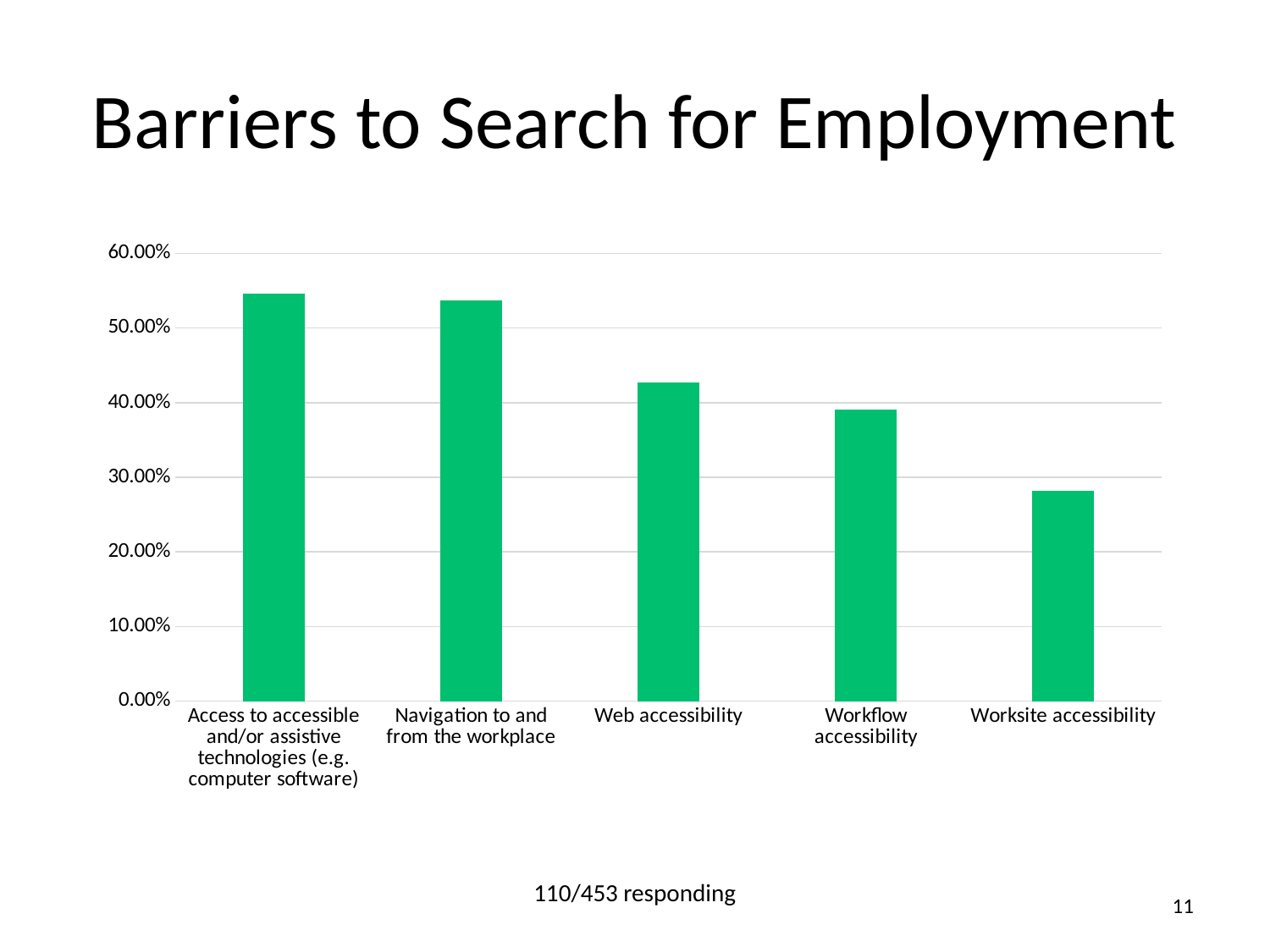
Is the value for Worksite accessibility greater or less than 30.00%? less Which is larger, the value for Navigation to and from the workplace or the value for Workflow accessibility? Navigation to and from the workplace Which is larger, the value for Web accessibility or the value for Worksite accessibility? Web accessibility What is the title of the chart on the slide? Barriers to Search for Employment Is the value for Access to accessible and/or assistive technologies greater or less than 50.00%? greater Which category has the lowest value? Worksite accessibility What kind of chart is shown on the slide? bar chart Do the values rise or fall moving from left to right across the categories? fall Is the value for Web accessibility greater or less than 50.00%? less How many categories (bars) does the chart show? 5